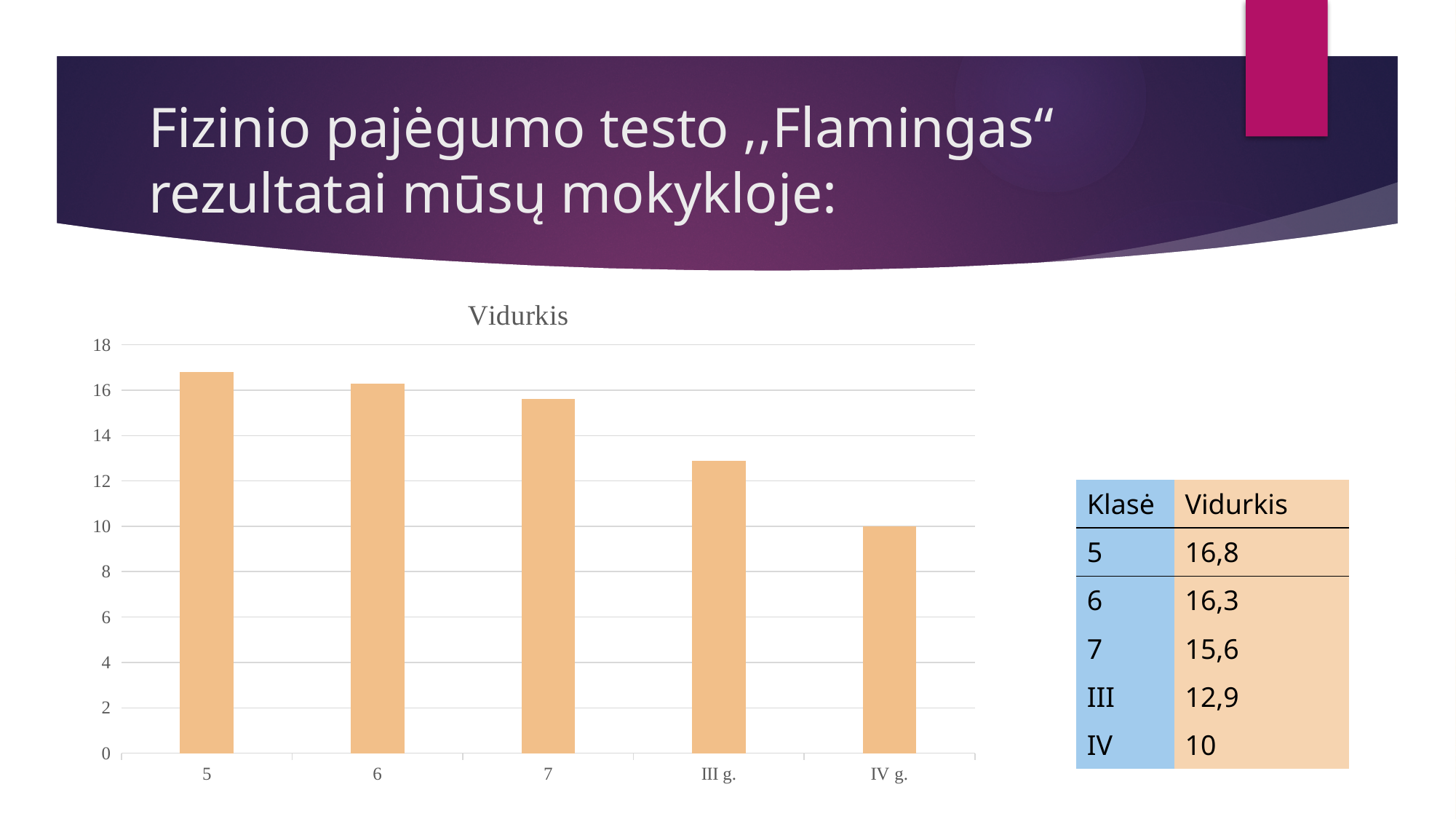
How many categories are plotted on the x axis of the chart? 5 What is the value for IV g. in the chart? 10 Do the bar values rise or fall from left to right along the x axis? fall Which category has the highest bar in the chart? 5 Is the value for III g. greater or less than 14? less Which category has the lowest bar in the chart? IV g. Which is larger, the value for 7 or the value for III g.? 7 What is the value for III g. according to the slide? 12,9 What kind of chart is shown on the slide? bar chart What is the title of the chart? Vidurkis Is the value for 7 greater or less than 14? greater What is the value for class 5 according to the slide? 16,8